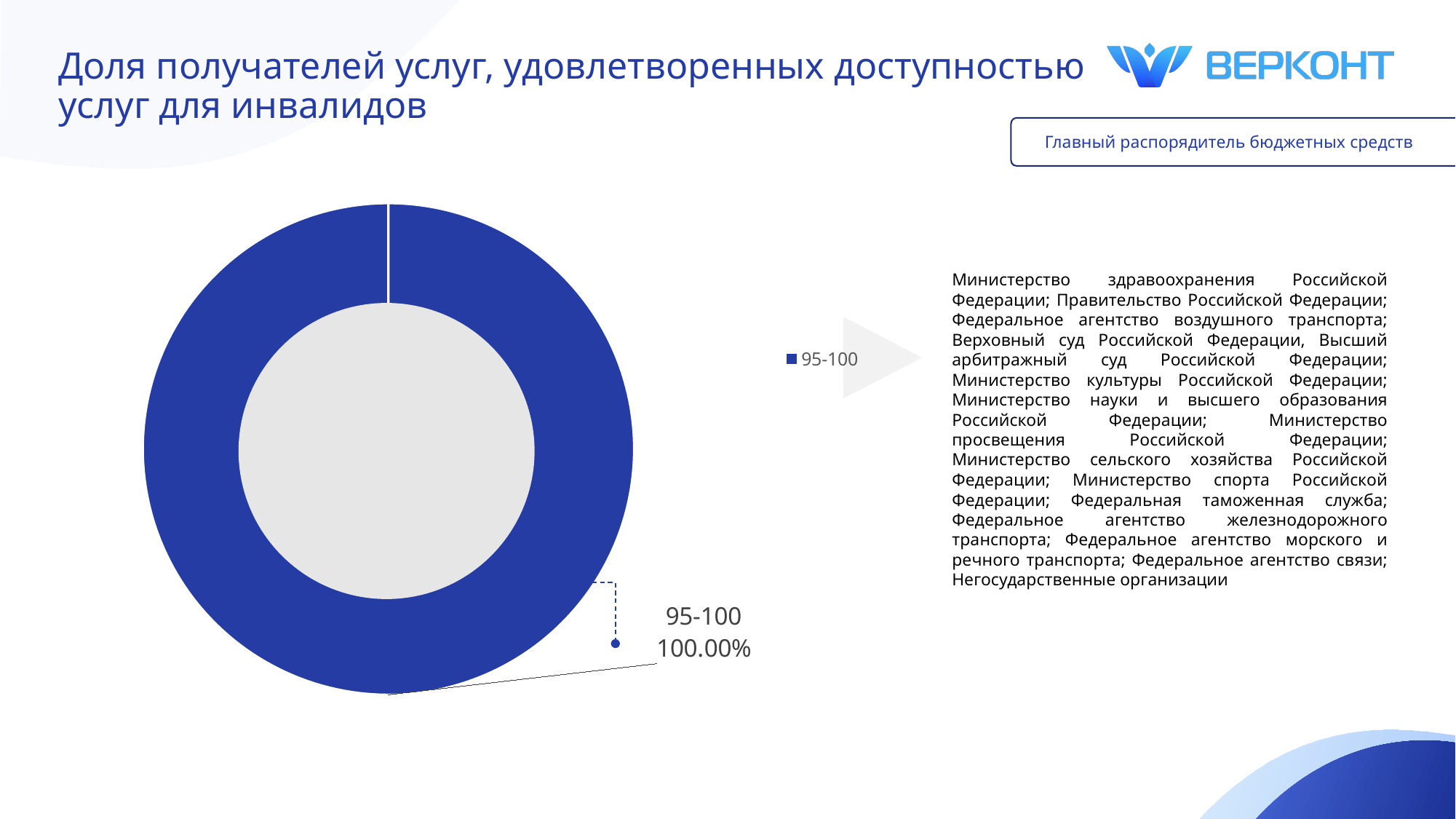
What colour is the "95-100" slice of the doughnut chart? Blue How many entries does the chart legend list? 1 Is the value for the "95-100" slice greater or less than 50%? greater What is the label of the only category shown in the chart legend? 95-100 What kind of chart is shown on the slide? Doughnut (pie) chart What value is printed on the data label for the "95-100" slice? 100.00% How many slices does the doughnut chart contain? 1 What share of the pie does the "95-100" slice take? 100.00%